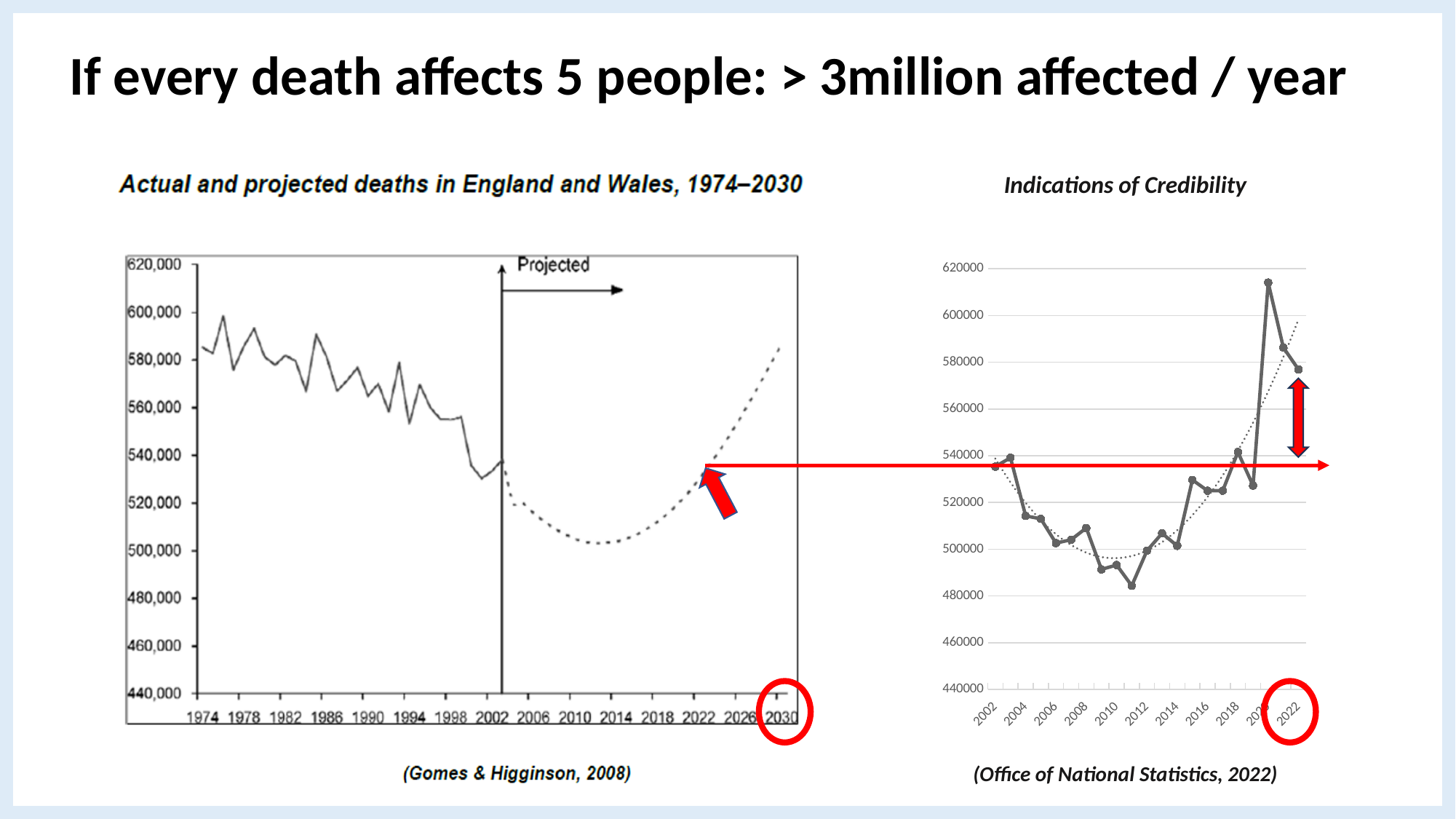
What source is cited beneath the left chart? Gomes & Higginson, 2008 In the right chart 'Indications of Credibility', which year has the highest value? 2020 In the right chart 'Indications of Credibility', is the value for 2022 greater or less than 560000? greater In the left chart 'Actual and projected deaths in England and Wales, 1974–2030', does the actual (solid) line generally rise or fall from 1974 to 2002? fall In the right chart 'Indications of Credibility', which is larger, the value for 2020 or the value for 2022? 2020 What kind of chart is the left chart titled 'Actual and projected deaths in England and Wales, 1974–2030'? line chart In the right chart 'Indications of Credibility', is the value for 2006 greater or less than 520000? less In the left chart 'Actual and projected deaths in England and Wales, 1974–2030', is the value for 1974 greater or less than 560,000? greater What kind of chart is the right chart titled 'Indications of Credibility'? line chart In the right chart 'Indications of Credibility', do the values generally rise or fall from 2012 to 2020? rise